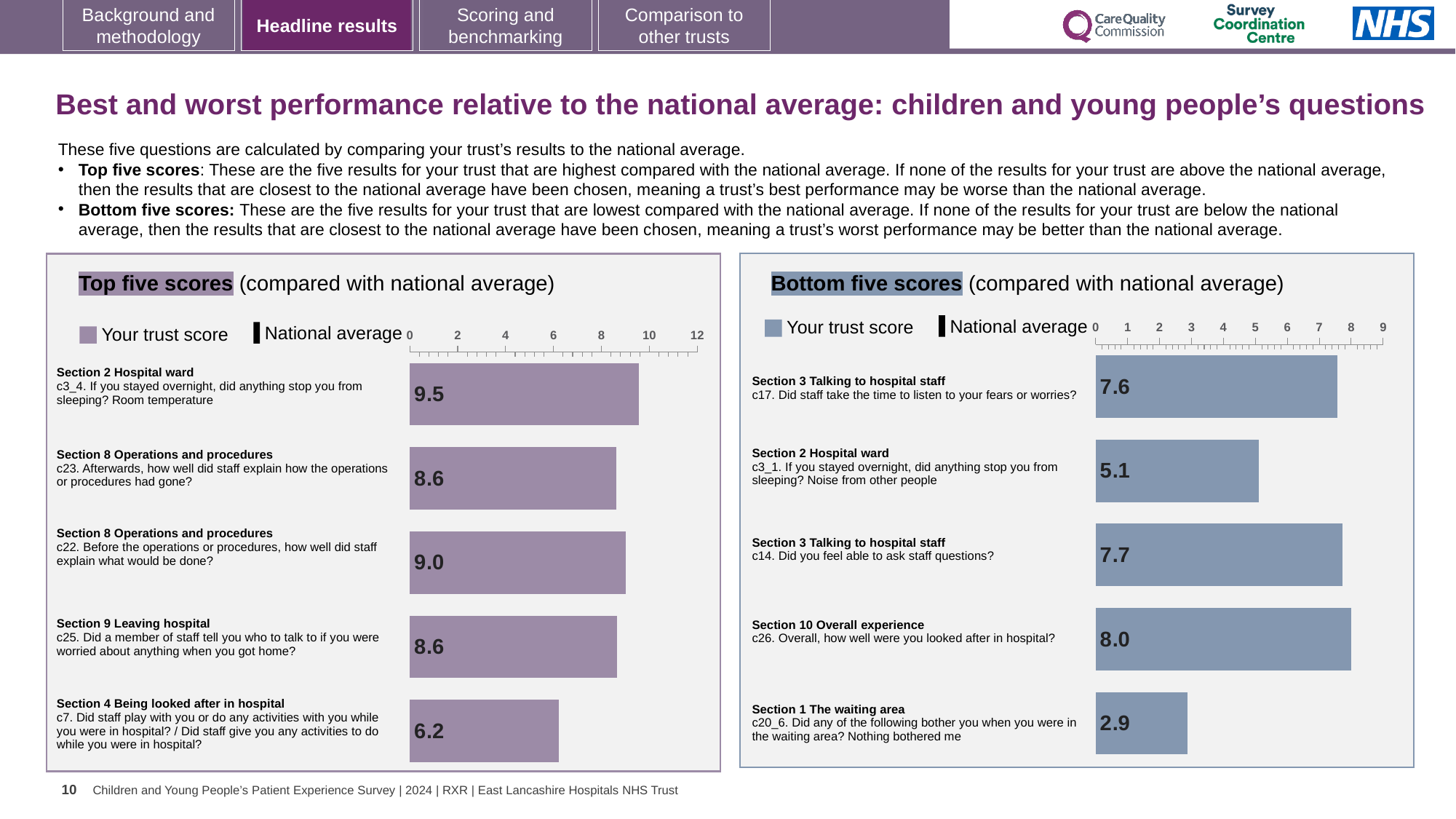
In the Bottom five scores chart, which has the larger trust score: c17 or c14? c14 In the Bottom five scores chart, what is the trust score for c26 (overall, how well were you looked after in hospital)? 8.0 What kind of chart is the Top five scores chart? Bar chart In the Top five scores chart, how many questions are plotted? 5 In the Top five scores chart, what is the trust score for c3_4 (did anything stop you from sleeping? Room temperature)? 9.5 In the Bottom five scores chart, which question has the lowest trust score? c20_6. Did any of the following bother you when you were in the waiting area? Nothing bothered me How many series does the legend of the Bottom five scores chart list? 2 In the Top five scores chart, what is the trust score for c7 (did staff play with you or do any activities with you)? 6.2 In the Bottom five scores chart, what is the trust score for c3_1 (noise from other people)? 5.1 In the Bottom five scores chart, what is the difference between the trust scores for c26 and c20_6? 5.1 In the Top five scores chart, what is the difference between the trust scores for c3_4 and c7? 3.3 In the Top five scores chart, which question has the highest trust score? c3_4. If you stayed overnight, did anything stop you from sleeping? Room temperature